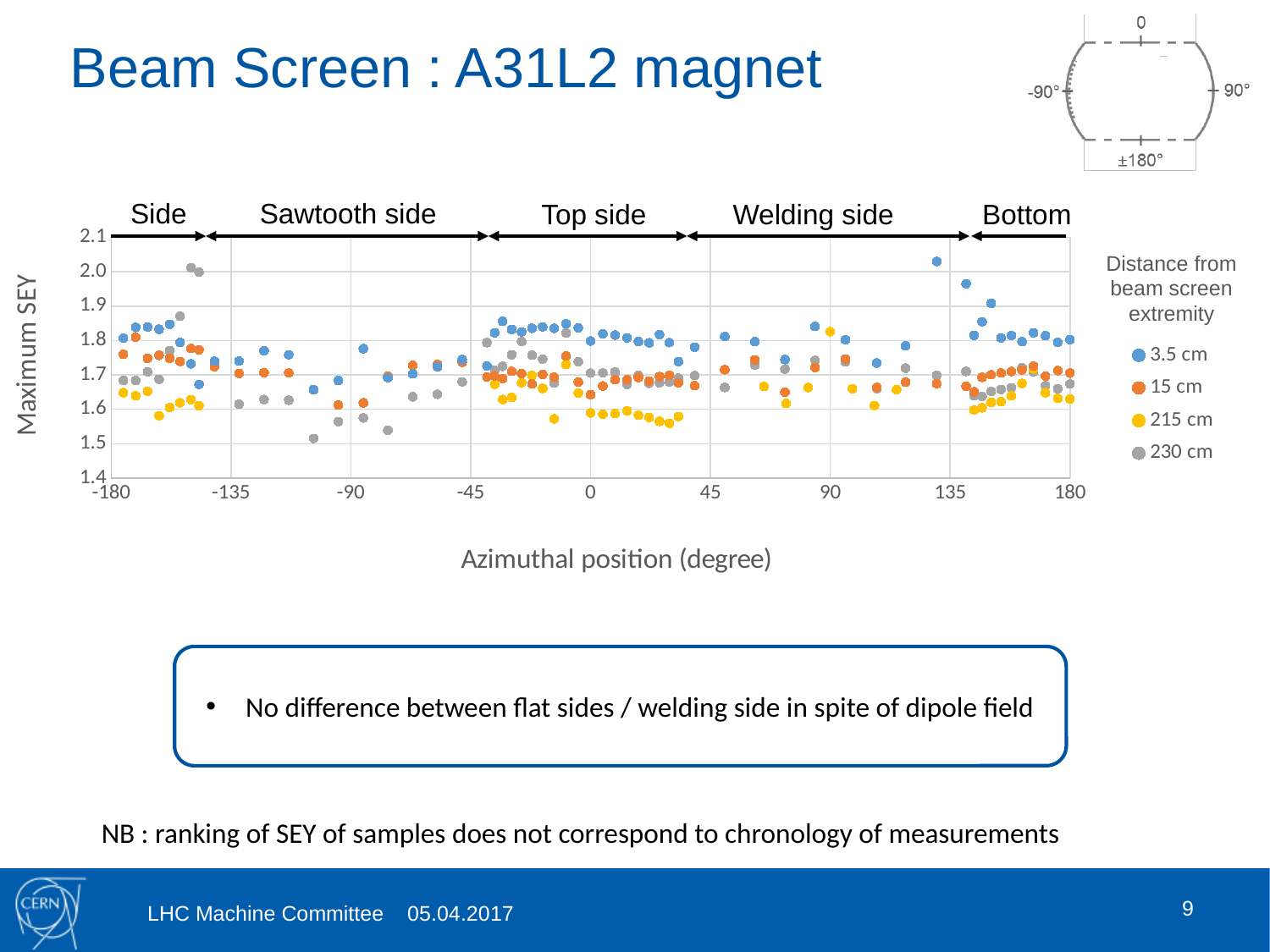
What kind of chart is shown on the slide? scatter chart At -180 degrees, which series has the higher Maximum SEY, 3.5 cm or 215 cm? 3.5 cm Is the value of the highest 3.5 cm point near 130 degrees greater or less than 1.9? greater What are the four series listed in the chart legend? 3.5 cm, 15 cm, 215 cm, 230 cm Near 0 degrees, which series has the lower Maximum SEY, 3.5 cm or 215 cm? 215 cm Is the value of the 215 cm point near -165 degrees greater or less than 1.7? less Is the value of the 230 cm point near -100 degrees greater or less than 1.6? less What is the title of the x axis of the chart? Azimuthal position (degree) How many series does the chart legend list? 4